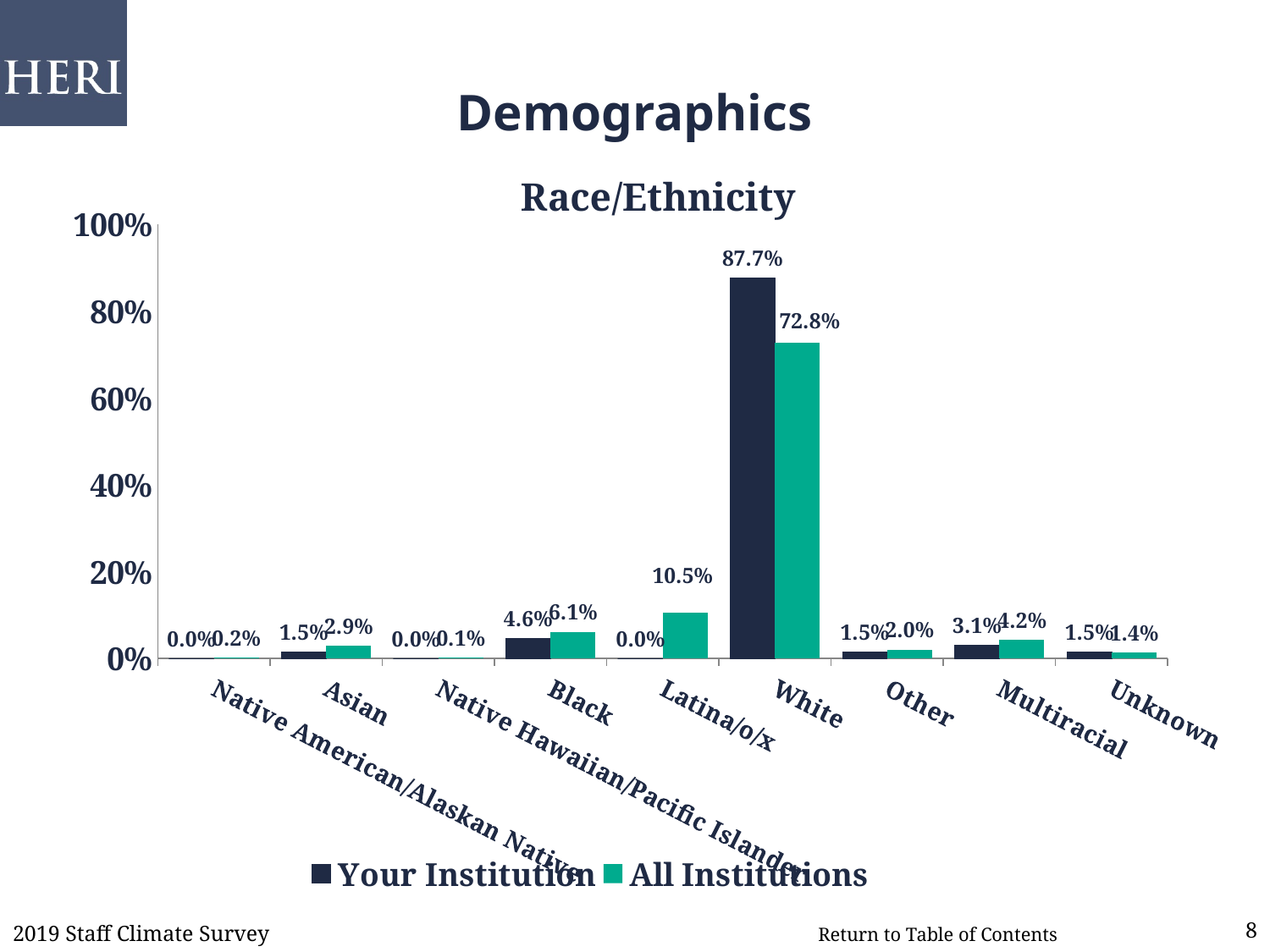
How many series does the legend list? 2 What is the difference between the Your Institution and All Institutions values for White? 14.9% What is the value for Black in the Your Institution series? 4.6% What is the value for Multiracial in the All Institutions series? 4.2% What is the value for Latina/o/x in the All Institutions series? 10.5% What kind of chart is shown on the slide? Bar chart What is the difference between the All Institutions and Your Institution values for Black? 1.5% Which category has the highest value in the Your Institution series? White What is the value for White in the All Institutions series? 72.8% What is the value for White in the Your Institution series? 87.7% Which is larger for Latina/o/x: the Your Institution value or the All Institutions value? All Institutions How many race/ethnicity categories are shown on the x axis? 9